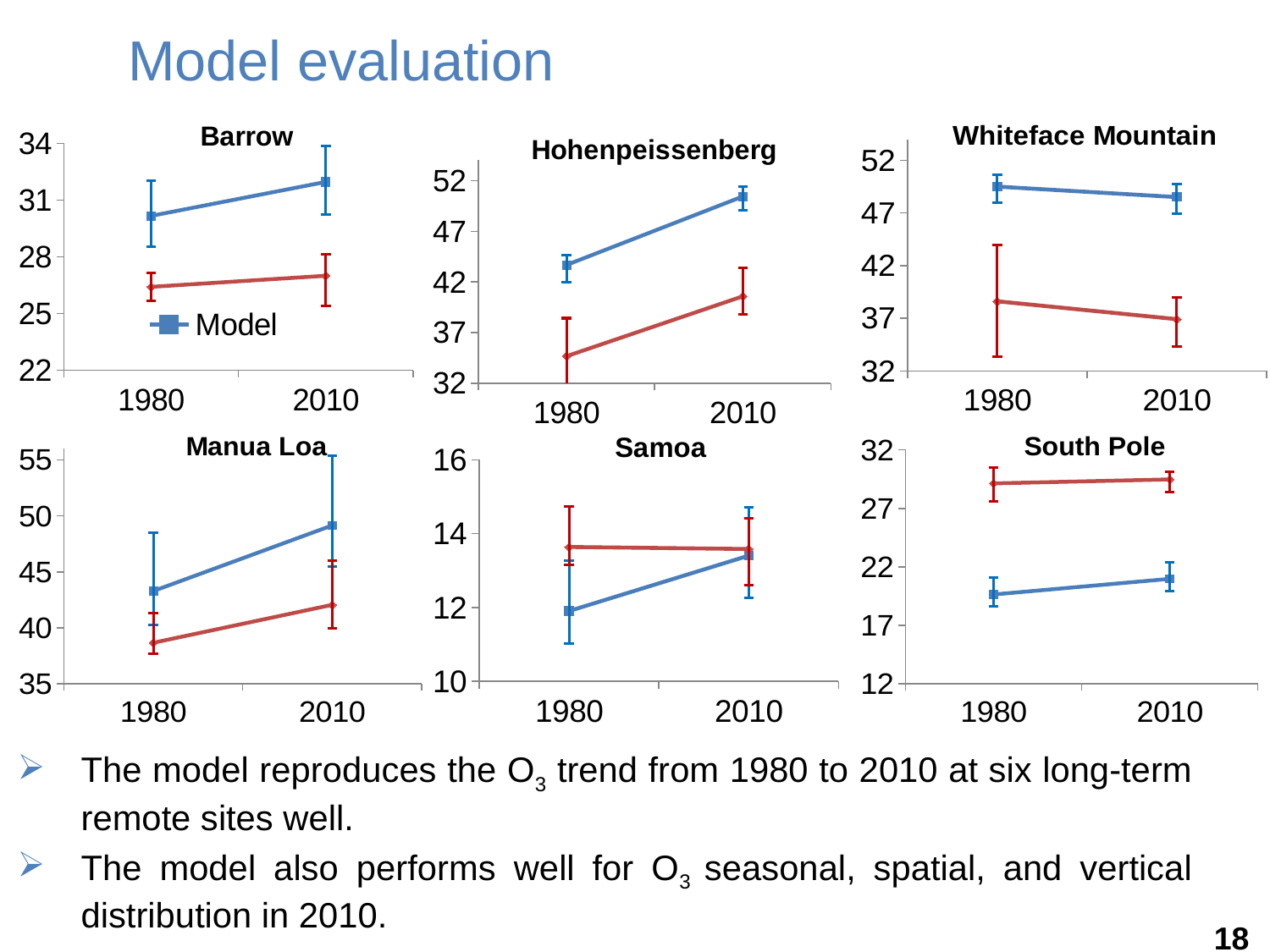
In the Manua Loa chart, does the Model series rise or fall from 1980 to 2010? rise In the South Pole chart, is the Model value for 1980 greater or less than 22? less In the South Pole chart, does the Model series rise or fall from 1980 to 2010? rise In the Whiteface Mountain chart, does the Model series rise or fall from 1980 to 2010? fall In the Barrow chart, which year has the larger Model value, 1980 or 2010? 2010 How many years are plotted on the x axis of the Samoa chart? 2 What kind of chart is the Barrow chart? line chart In the Hohenpeissenberg chart, is the Model value for 1980 greater or less than 47? less What series name is shown in the legend of the Barrow chart? Model In the Barrow chart, is the Model value for 2010 greater or less than 31? greater